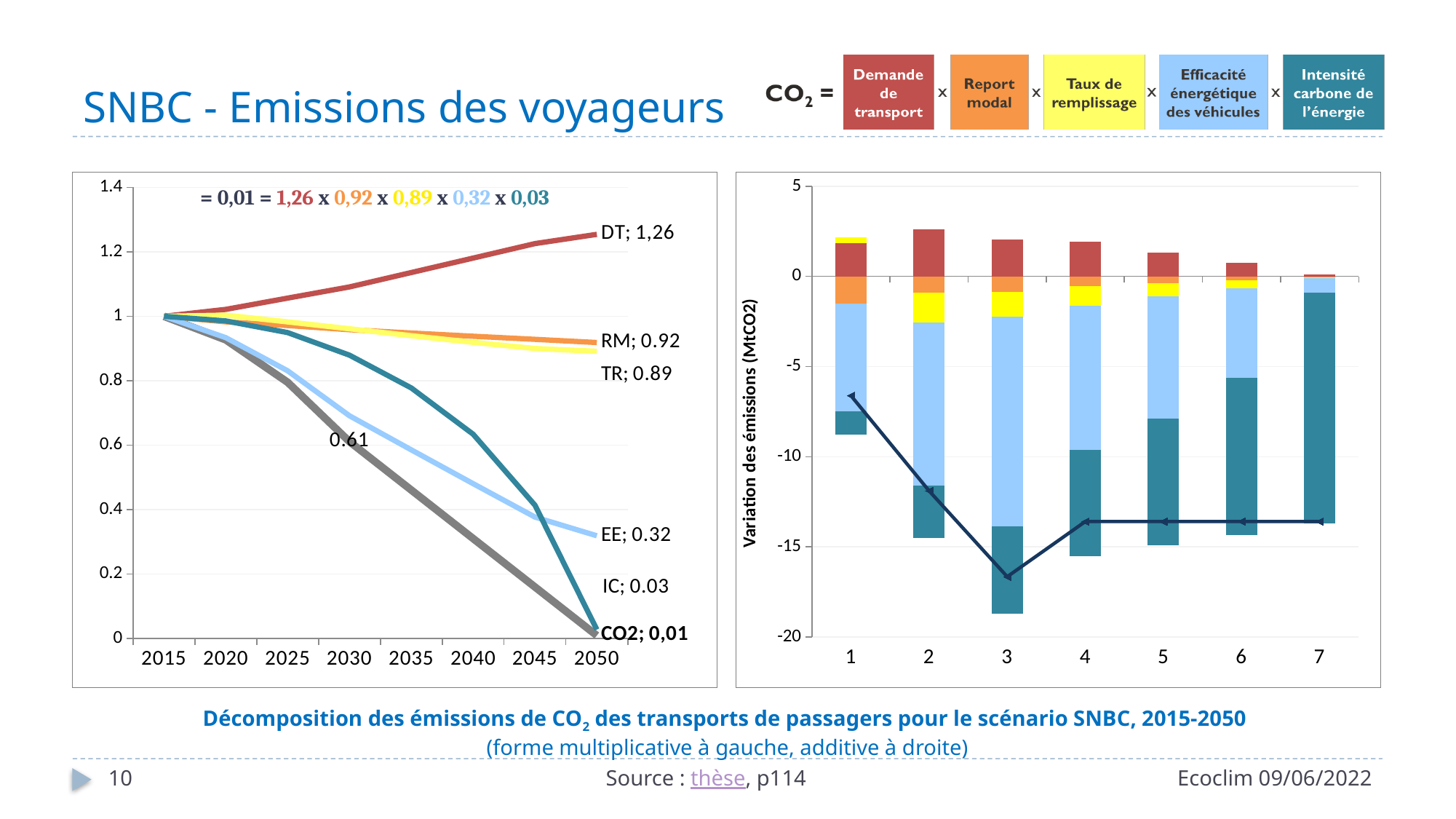
In the left line chart, which series has the lowest value in 2050? CO2 How many year ticks are shown on the x axis of the left line chart? 8 In the left line chart, which is larger in 2050, RM or TR? RM What is the y-axis label of the right chart? Variation des émissions (MtCO2) In the left line chart, what is the difference between the 2050 values of RM and TR? 0.03 What kind of chart is the chart on the right of the slide? combination stacked bar and line chart In the right chart, is the value of the dark line at category 3 greater or less than -15? less In the left line chart, what is the value shown for DT in 2050? 1,26 In the left line chart, what value is labelled on the grey CO2 line around 2030? 0.61 In the left line chart, does the DT line rise or fall from 2015 to 2050? rise In the left line chart, which series has the highest value in 2050? DT In the left line chart, what is the value shown for EE in 2050? 0.32